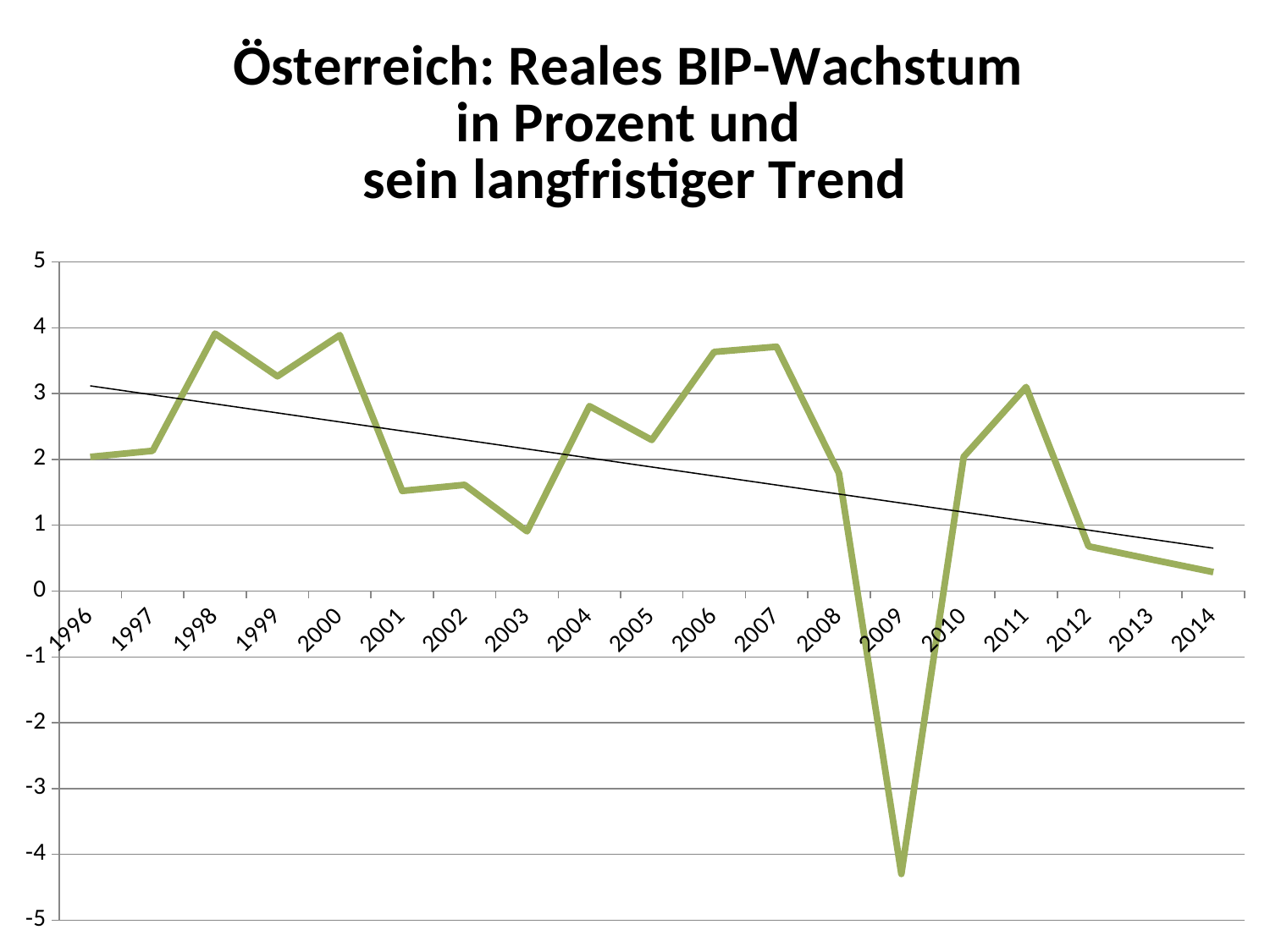
Which year has the larger value, 2011 or 2012? 2011 What kind of chart is shown on the slide? line chart Which year has the lowest real GDP growth value in the chart? 2009 Does the long-term trend line rise or fall from 1996 to 2014? fall Is the value for 2009 greater or less than -4? less Is the value for 2014 greater or less than 1? less What is the title of the chart? Österreich: Reales BIP-Wachstum in Prozent und sein langfristiger Trend Is the value for 2006 greater or less than 3? greater How many years are plotted along the x axis? 19 Which year has the larger value, 2009 or 2010? 2010